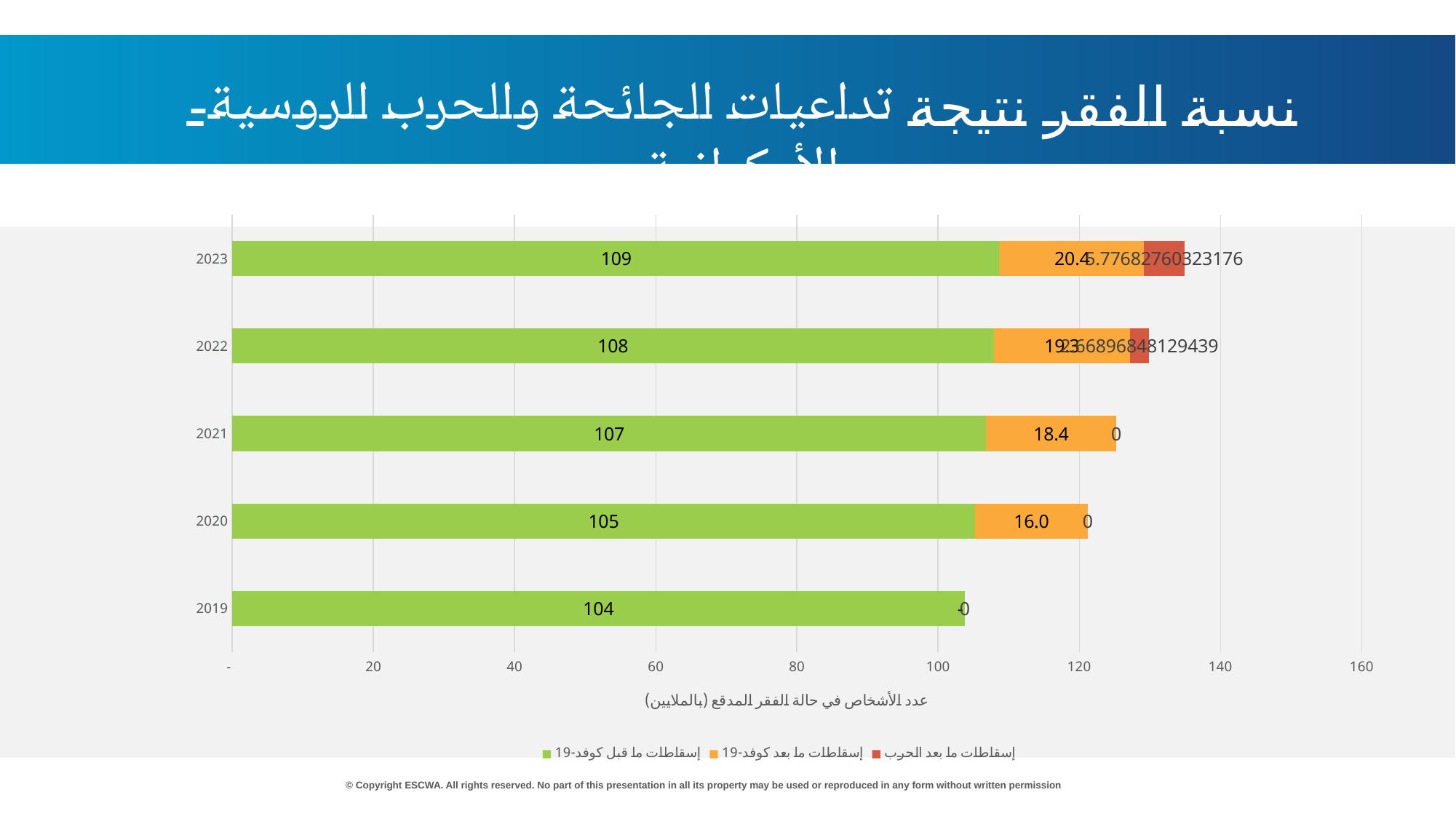
What is the pre-COVID-19 projection (green segment) value for 2023? 109 What is the pre-COVID-19 projection (green segment) value for 2019? 104 What is the difference between the pre-COVID-19 projection values for 2023 and 2019? 5 What is the post-COVID-19 projection (orange segment) value for 2020? 16.0 What kind of chart is shown on the slide? Stacked horizontal bar chart Is the total length of the 2023 bar greater or less than 120? greater What is the post-COVID-19 projection (orange segment) value for 2021? 18.4 Which is larger, the post-COVID-19 projection value for 2021 or for 2020? 2021 How many years are shown on the chart? 5 How many series does the legend list? 3 Which year has the lowest pre-COVID-19 projection (green segment) value? 2019 Which year has the highest pre-COVID-19 projection (green segment) value? 2023